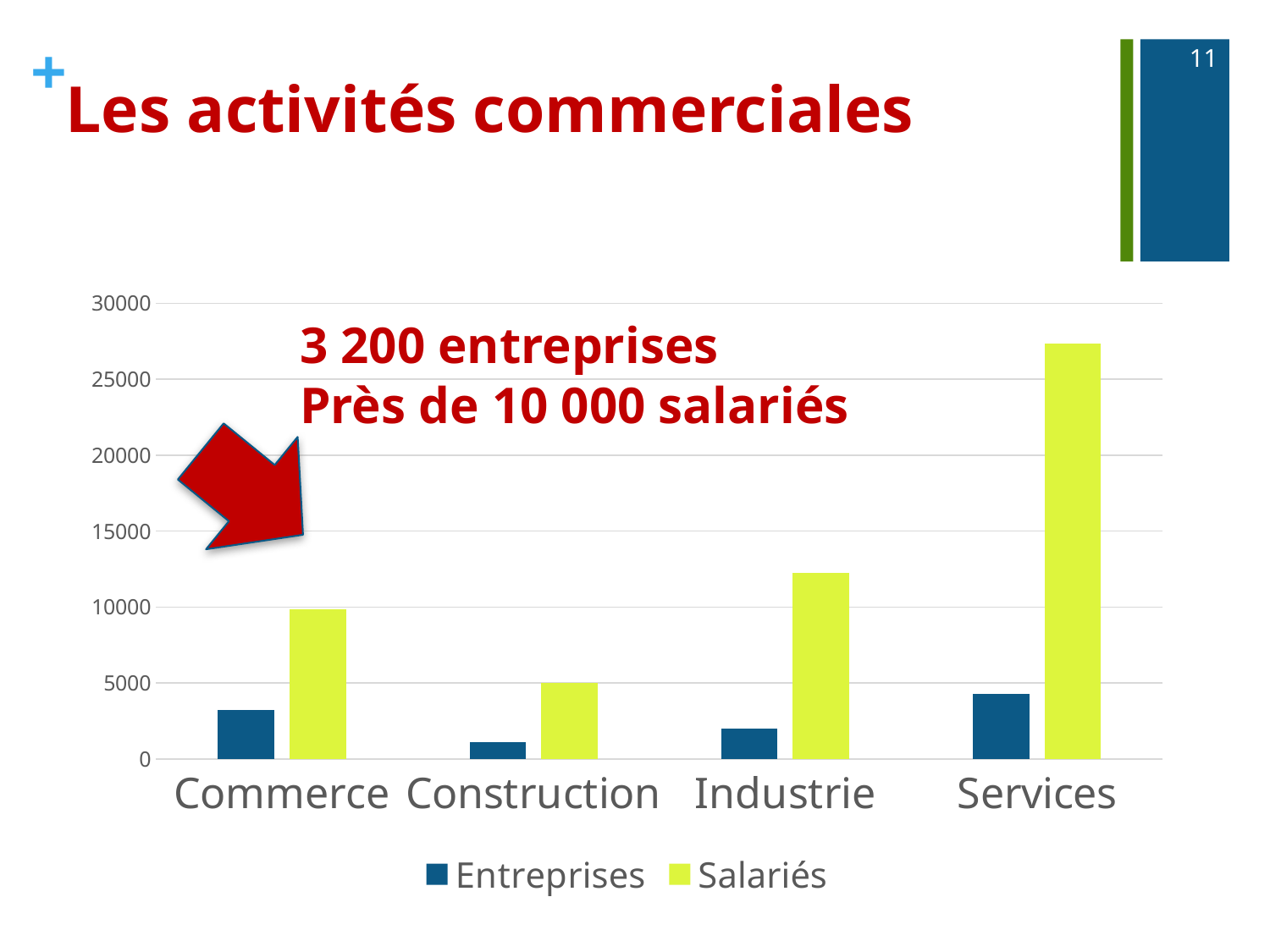
How many series does the chart's legend list? 2 What are the two series named in the chart's legend? Entreprises and Salariés Which category has the highest value for Salariés? Services Which category has the lowest value for Salariés? Construction Is the Salariés value for Industrie greater or less than 10000? greater Is the Entreprises value for Commerce greater or less than 5000? less Which category has the lowest value for Entreprises? Construction What kind of chart is shown on the slide? bar chart How many categories are shown on the x axis of the chart? 4 Is the Salariés value for Services greater or less than 25000? greater Which is larger, the Salariés value for Industrie or the Salariés value for Commerce? Industrie Which category has the highest value for Entreprises? Services